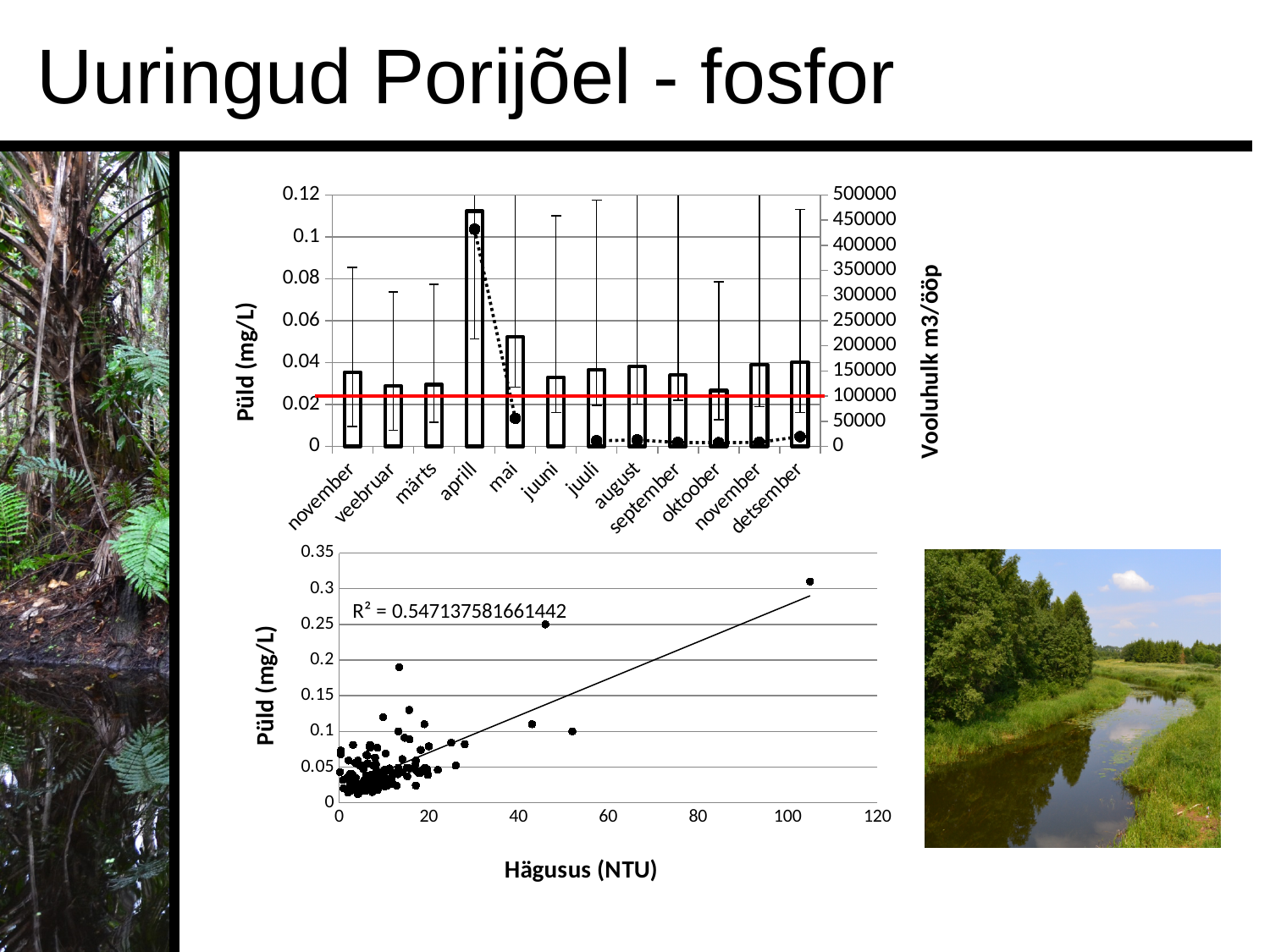
What is the title of the right-hand vertical axis of the top chart? Vooluhulk m3/ööp What kind of chart is the top chart on the slide? combination bar and line chart What R² value is printed on the bottom chart? R² = 0.547137581661442 In the top chart, is the Püld (mg/L) bar for mai greater or less than 0.04? greater In the top chart, is the Püld (mg/L) bar for oktoober greater or less than 0.04? less In the bottom chart, does the fitted trend line rise or fall as Hägusus (NTU) increases? rise What kind of chart is the bottom chart on the slide? scatter chart In the top chart, is the Püld (mg/L) bar for aprill greater or less than 0.1? greater In the top chart, how many month categories are shown on the x axis? 12 In the top chart, which month has the highest Püld (mg/L) bar? aprill In the top chart, which has the larger Püld (mg/L) bar, mai or juuni? mai In the top chart, which has the larger Püld (mg/L) bar, aprill or mai? aprill